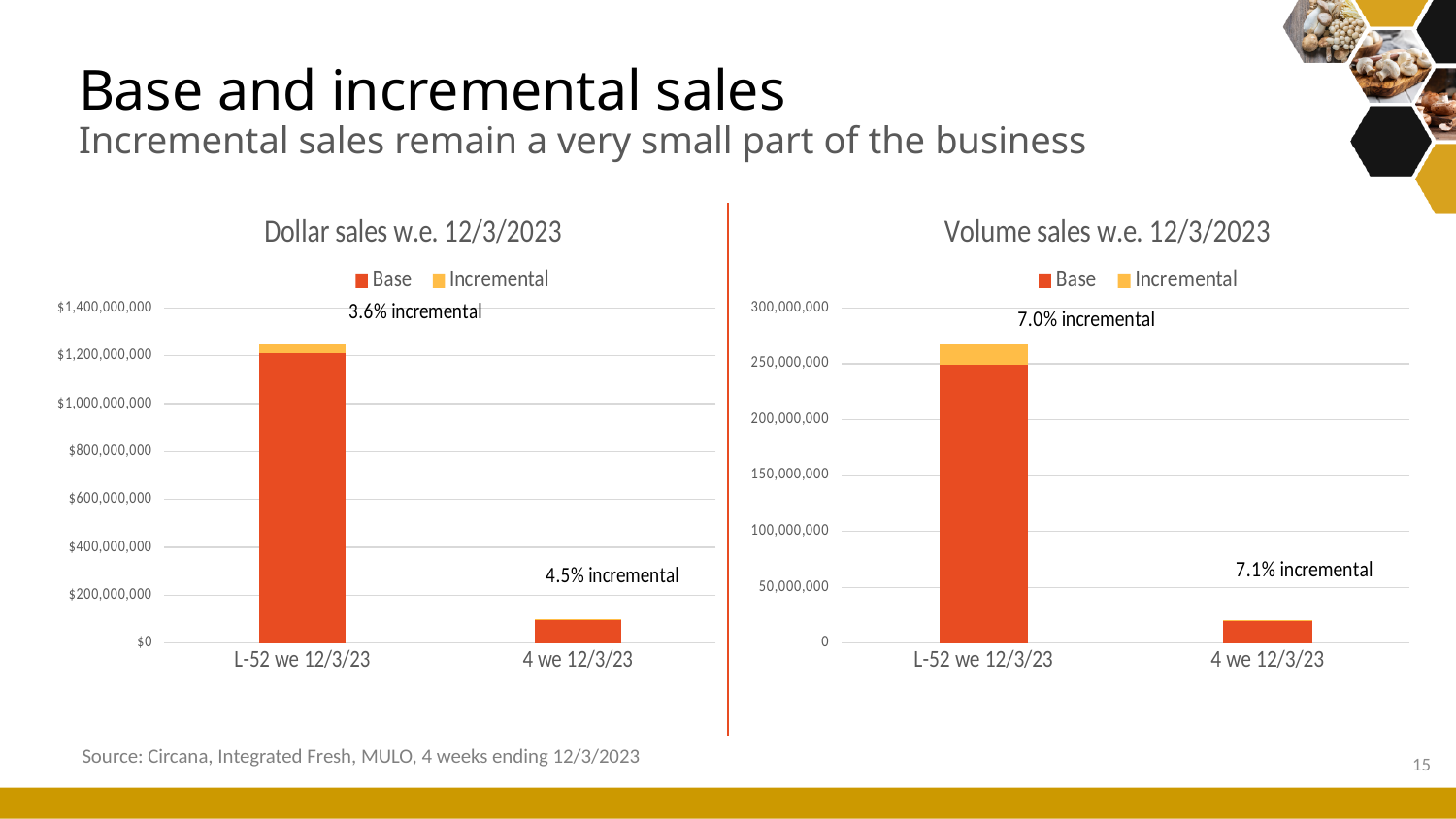
In the 'Dollar sales w.e. 12/3/2023' chart, is the Base value for L-52 we 12/3/23 greater or less than $1,000,000,000? greater How many categories are shown on the x axis of the 'Dollar sales w.e. 12/3/2023' chart? 2 In the 'Dollar sales w.e. 12/3/2023' chart, what incremental percentage is annotated for 4 we 12/3/23? 4.5% incremental In the 'Dollar sales w.e. 12/3/2023' chart, which series is shown in orange-red? Base In the 'Volume sales w.e. 12/3/2023' chart, what incremental percentage is annotated for L-52 we 12/3/23? 7.0% incremental In the 'Volume sales w.e. 12/3/2023' chart, what incremental percentage is annotated for 4 we 12/3/23? 7.1% incremental In the 'Dollar sales w.e. 12/3/2023' chart, which category has the taller bar? L-52 we 12/3/23 In the 'Volume sales w.e. 12/3/2023' chart, is the total bar for 4 we 12/3/23 greater or less than 50,000,000? less In the 'Dollar sales w.e. 12/3/2023' chart, what incremental percentage is annotated for L-52 we 12/3/23? 3.6% incremental In the 'Volume sales w.e. 12/3/2023' chart, which category has the shorter bar? 4 we 12/3/23 How many series does the legend of the 'Volume sales w.e. 12/3/2023' chart list? 2 What kind of chart is the 'Dollar sales w.e. 12/3/2023' chart? Stacked bar chart